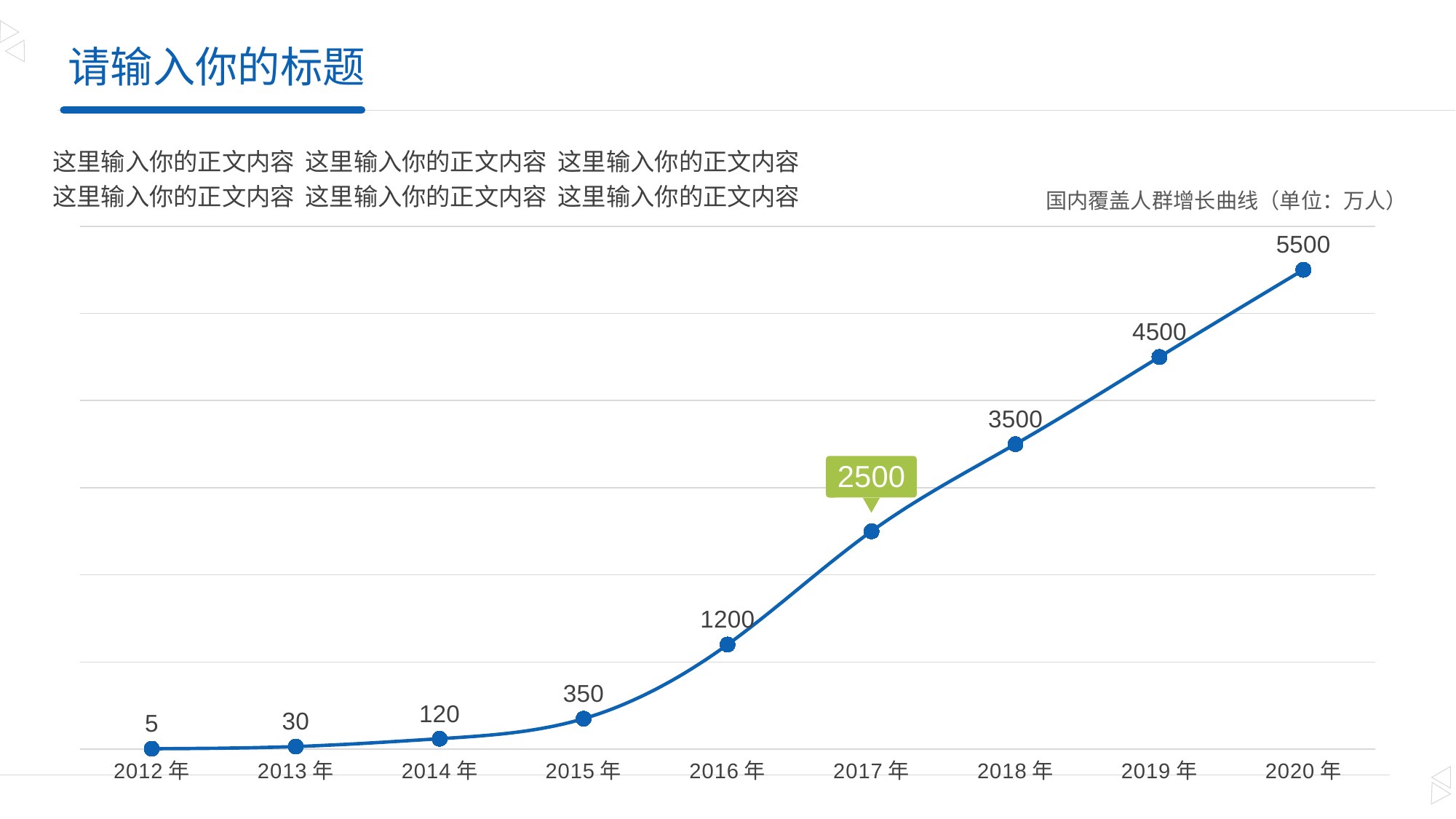
Do the values rise or fall from 2012 年 to 2020 年? Rise What is the title of the chart? 国内覆盖人群增长曲线（单位：万人） What is the value for 2017 年? 2500 What is the value for 2016 年? 1200 Which year has the highest value? 2020 年 How many data points are plotted on the chart? 9 What is the value for 2013 年? 30 What kind of chart is shown on the slide? Line chart What is the difference between the values for 2018 年 and 2016 年? 2300 Which is larger, the value for 2015 年 or the value for 2014 年? 2015 年 Which year has the lowest value? 2012 年 What is the difference between the values for 2020 年 and 2019 年? 1000